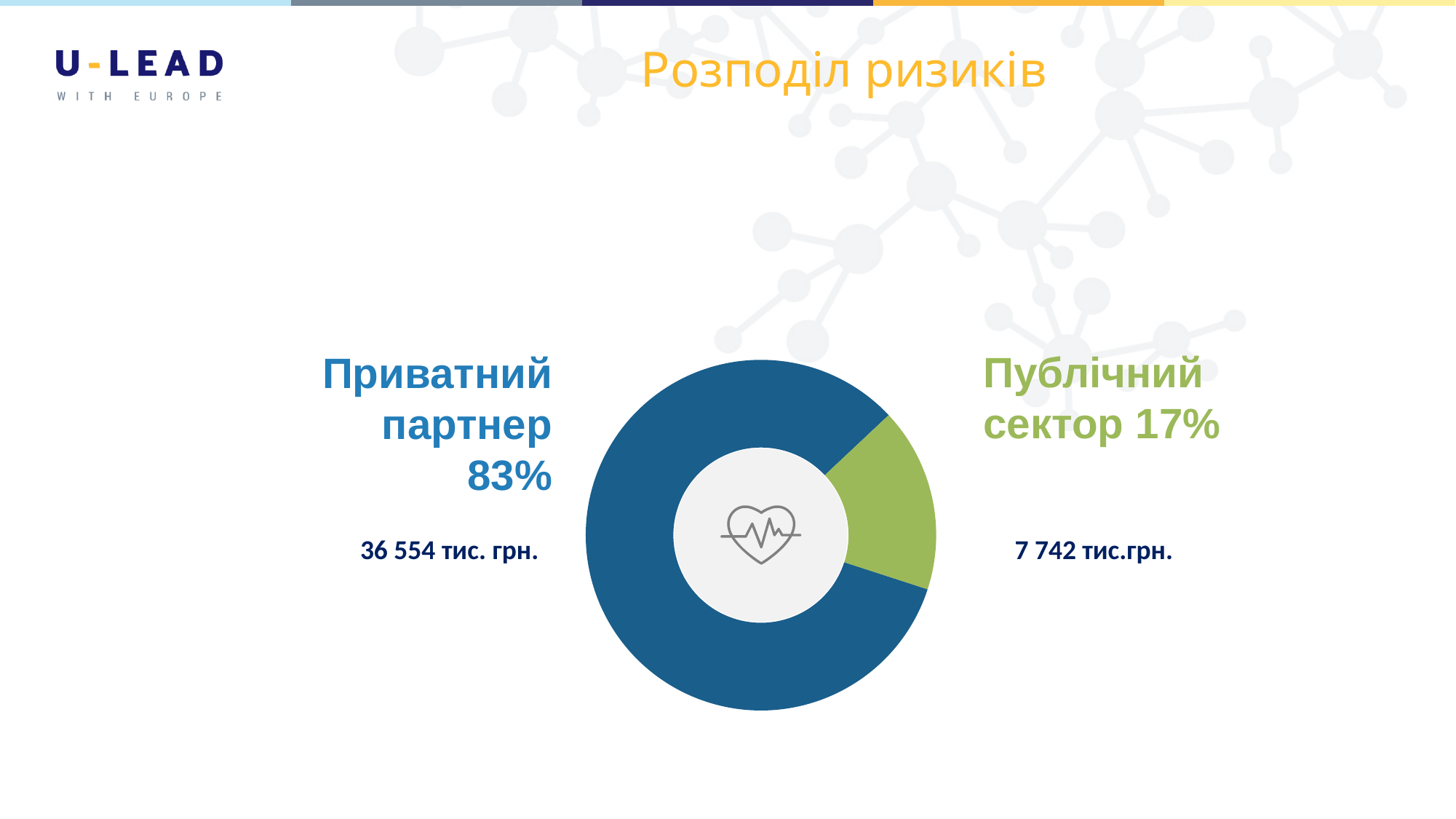
Which category has the largest slice of the chart? Приватний партнер What is the title of the slide containing the chart? Розподіл ризиків What is the difference in тис. грн. between Приватний партнер and Публічний сектор? 28 812 тис. грн. How many categories are shown in the chart? 2 What is the combined total in тис. грн. of the two slices? 44 296 тис. грн. What value in тис. грн. is shown for Приватний партнер? 36 554 тис. грн. Which category has the smallest slice of the chart? Публічний сектор What value in тис. грн. is shown for Публічний сектор? 7 742 тис.грн. What share of the chart does the Публічний сектор slice represent? 17% What share of the chart does the Приватний партнер slice represent? 83% Which is larger, the value for Приватний партнер or for Публічний сектор? Приватний партнер What kind of chart is shown on the slide? Pie (donut) chart